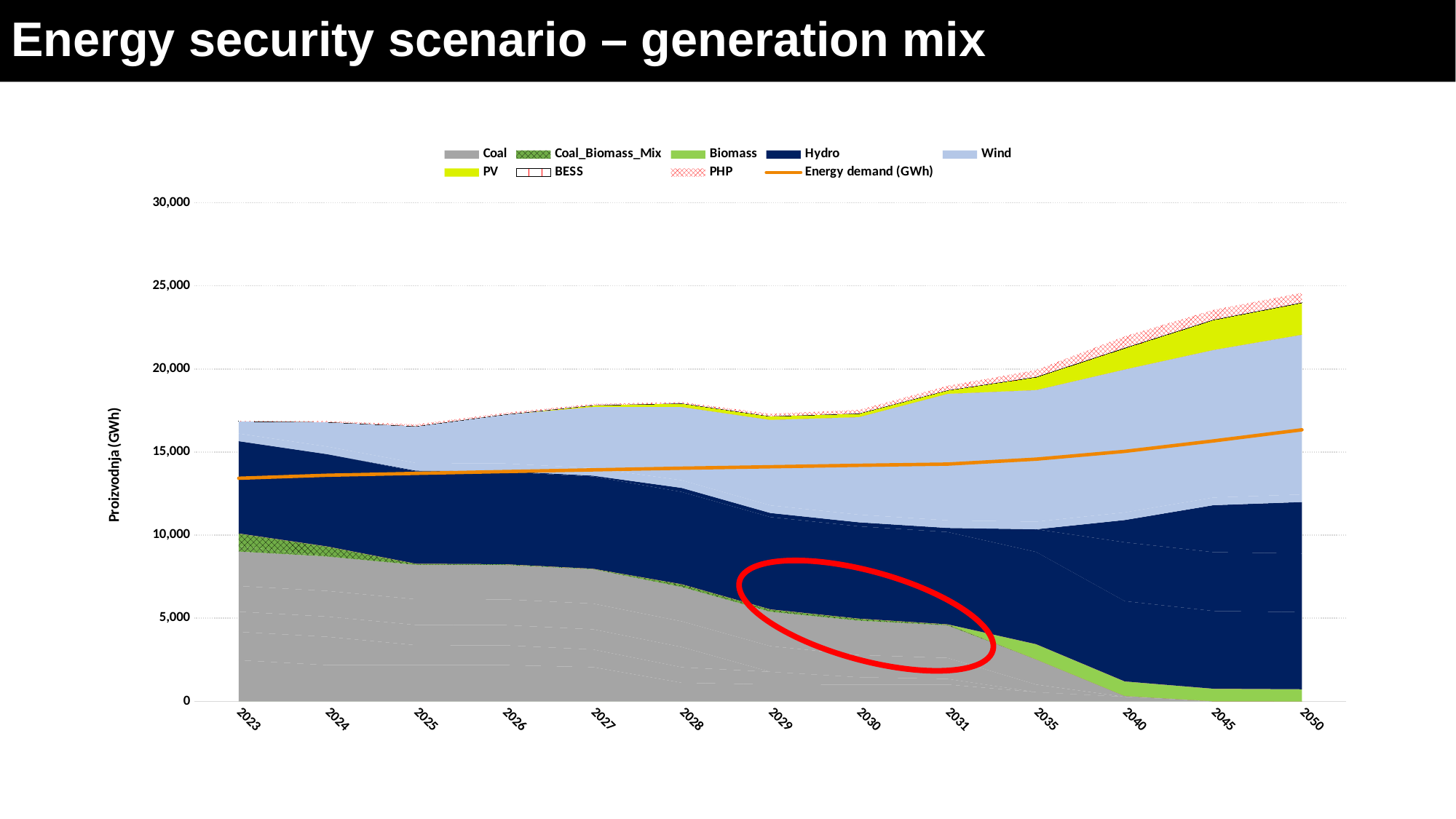
How many series does the legend list? 9 Which legend entry is drawn as an orange line rather than a filled area? Energy demand (GWh) What is the label of the y axis? Proizvodnja (GWh) Which year has the highest total stacked generation? 2050 How many years are shown on the x axis? 13 Is the Energy demand (GWh) value in 2050 greater or less than 15,000? greater What kind of chart is shown on the slide? Stacked area chart with a line Is the Coal value in 2023 greater or less than 5,000? greater Is the total stacked generation in 2050 greater or less than 20,000? greater Does the Energy demand (GWh) line rise or fall from 2023 to 2050? rise